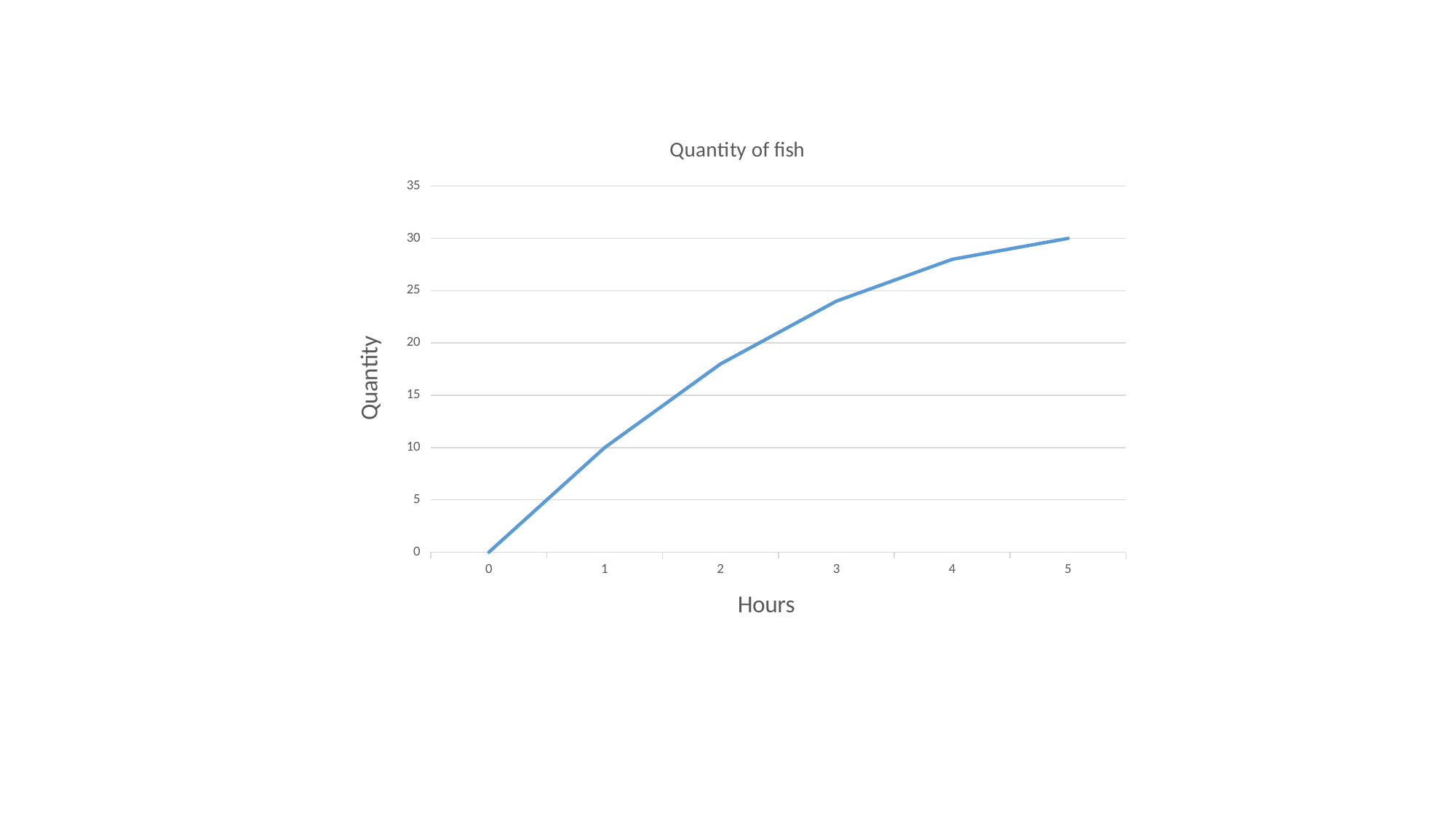
What is the quantity at 1 hour? 10 At which hour is the quantity lowest? 0 What is the label of the x axis? Hours What is the difference between the quantity at 5 hours and the quantity at 1 hour? 20 At which hour is the quantity highest? 5 What is the title of the chart? Quantity of fish What kind of chart is shown on the slide? line chart Does the quantity rise or fall as hours increase? rise How many data points are plotted on the line? 6 Is the quantity at 2 hours greater or less than 15? greater What is the quantity at 0 hours? 0 What is the quantity at 5 hours? 30